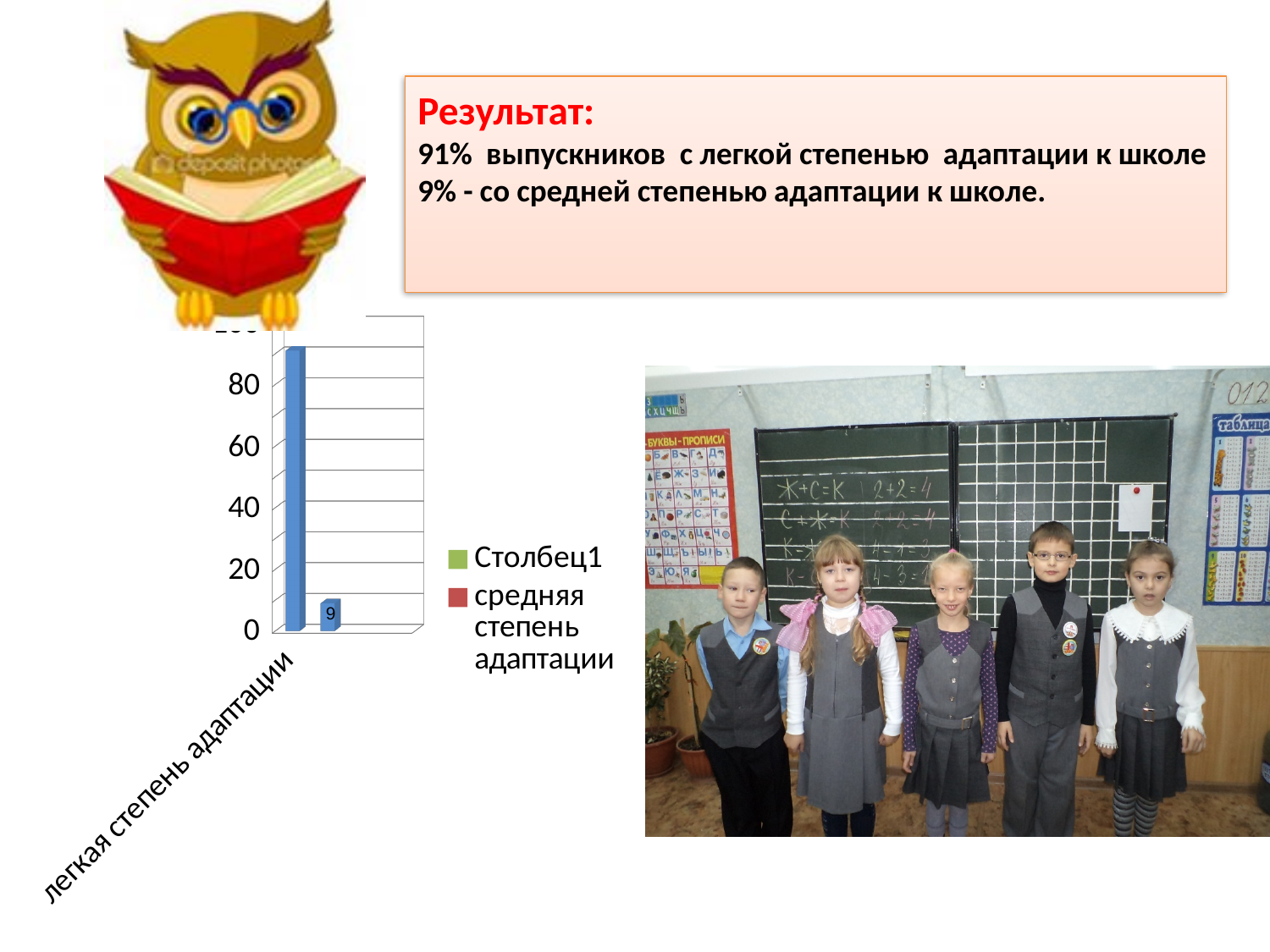
What are the two entries listed in the chart legend? Столбец1; средняя степень адаптации Is the value of the taller bar in the chart greater or less than 60? greater What category label is shown on the horizontal axis of the chart? легкая степень адаптации Is the value of the shorter bar in the chart greater or less than 20? less How many bars are plotted in the chart? 2 Which bar is taller in the chart, the left bar or the right bar labelled 9? the left bar What kind of chart is shown on the slide? bar chart Is the value of the taller bar in the chart greater or less than 80? greater How many series does the chart legend list? 2 What value is printed on the shorter bar in the chart? 9